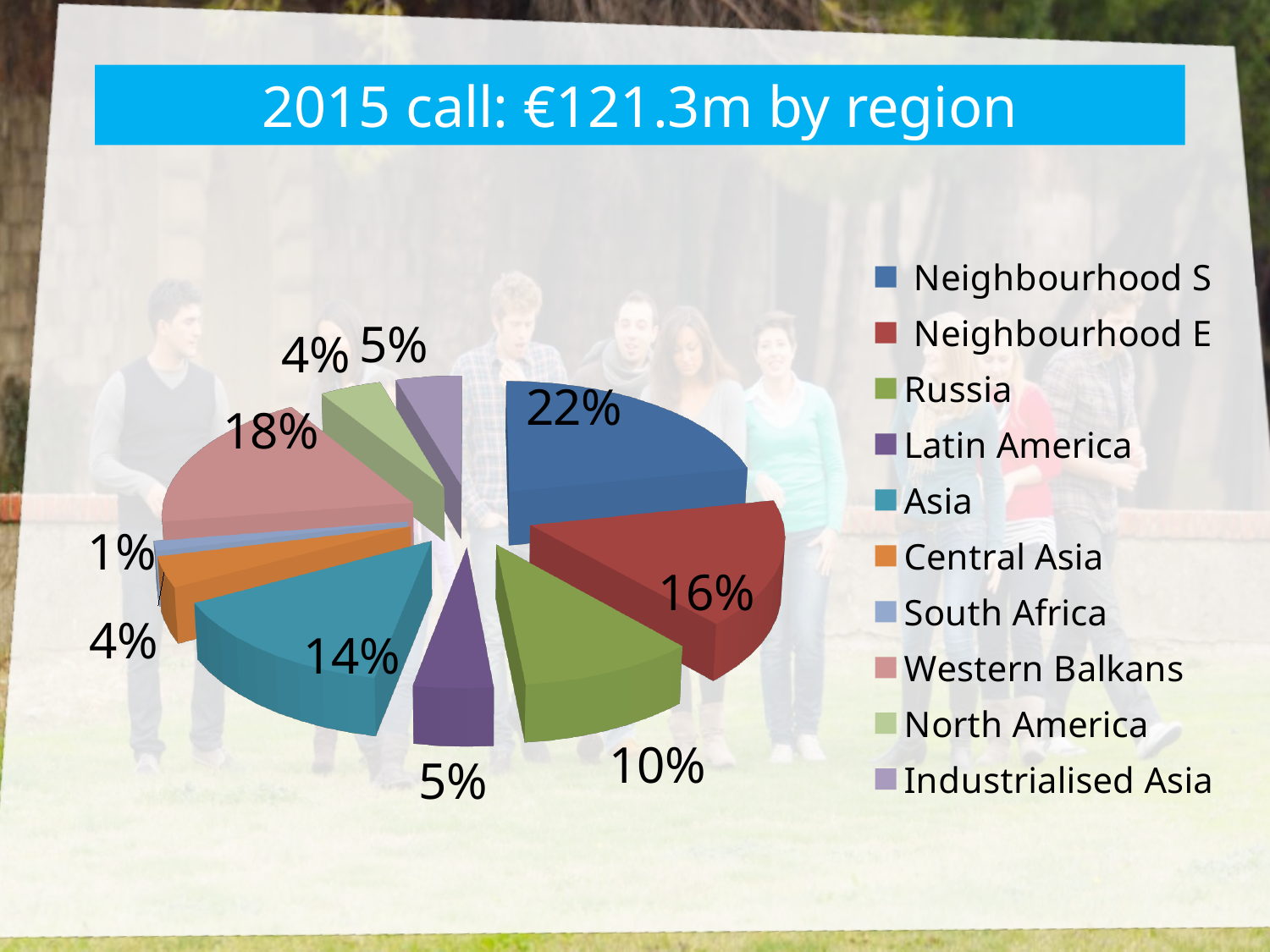
Which region has the largest share of the pie? Neighbourhood S How many regions does the legend list? 10 What is the difference in percentage points between Neighbourhood S and Neighbourhood E? 6 What share of the pie does Western Balkans have? 18% What kind of chart is shown on the slide? Pie chart What colour is the slice for Latin America? Purple Which region has the smallest share of the pie? South Africa What is the title of the chart? 2015 call: €121.3m by region What share of the pie does Asia have? 14% What share of the pie does Russia have? 10% Which has a larger share, Western Balkans or Neighbourhood E? Western Balkans